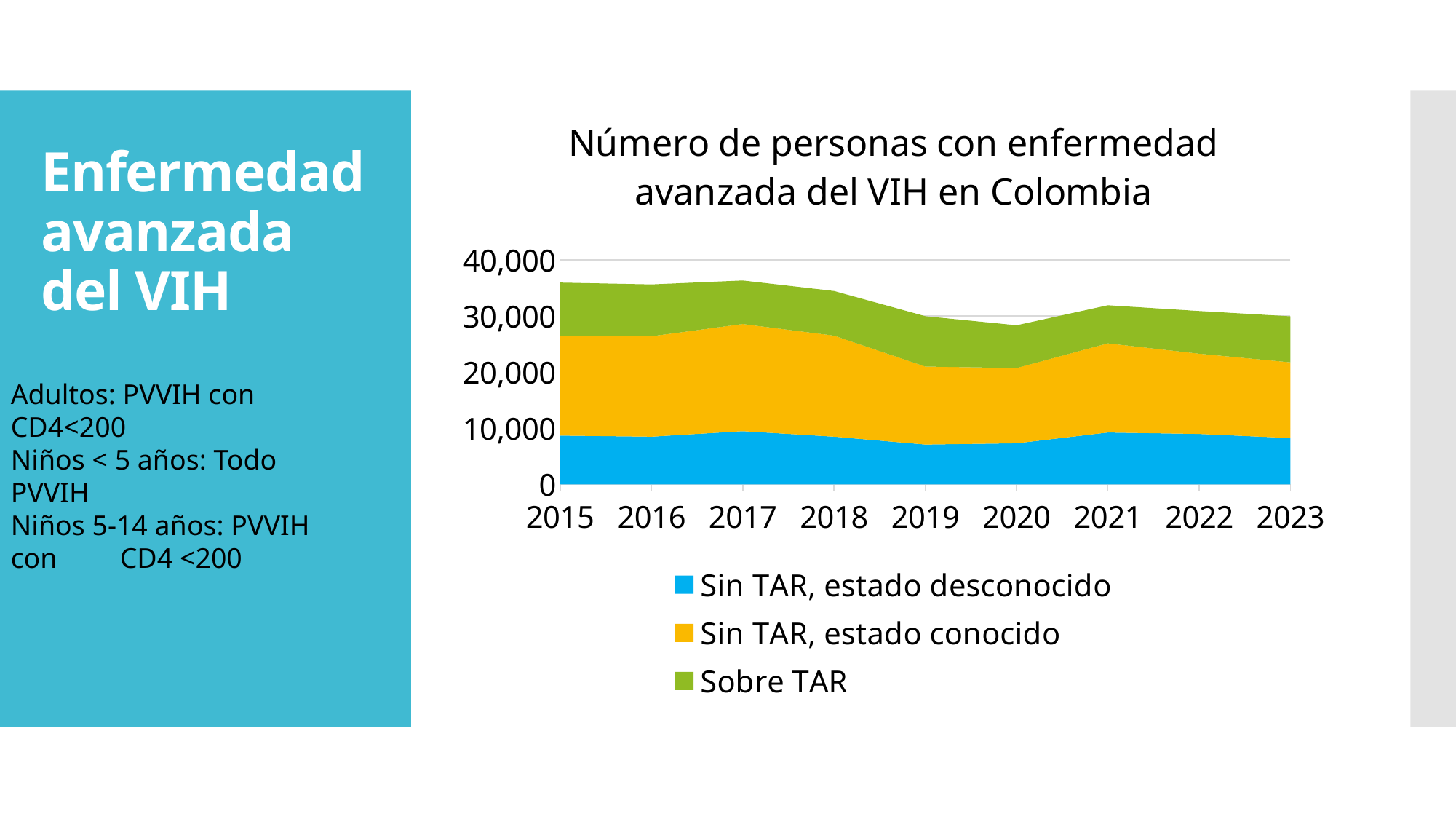
Is the total in 2015 larger or smaller than the total in 2020? larger What kind of chart is shown on the slide? Stacked area chart How many series does the legend list? 3 Does the total number of people rise or fall between 2017 and 2020? fall Is the value for 'Sin TAR, estado desconocido' in 2020 greater or less than 10,000? less What is the title of the chart? Número de personas con enfermedad avanzada del VIH en Colombia Is the total number of people in 2015 greater or less than 30,000? greater Which year has the lowest total number of people with advanced HIV disease? 2020 Which series is shown in green? Sobre TAR Is the total number of people in 2017 greater or less than 30,000? greater How many years are shown on the x axis? 9